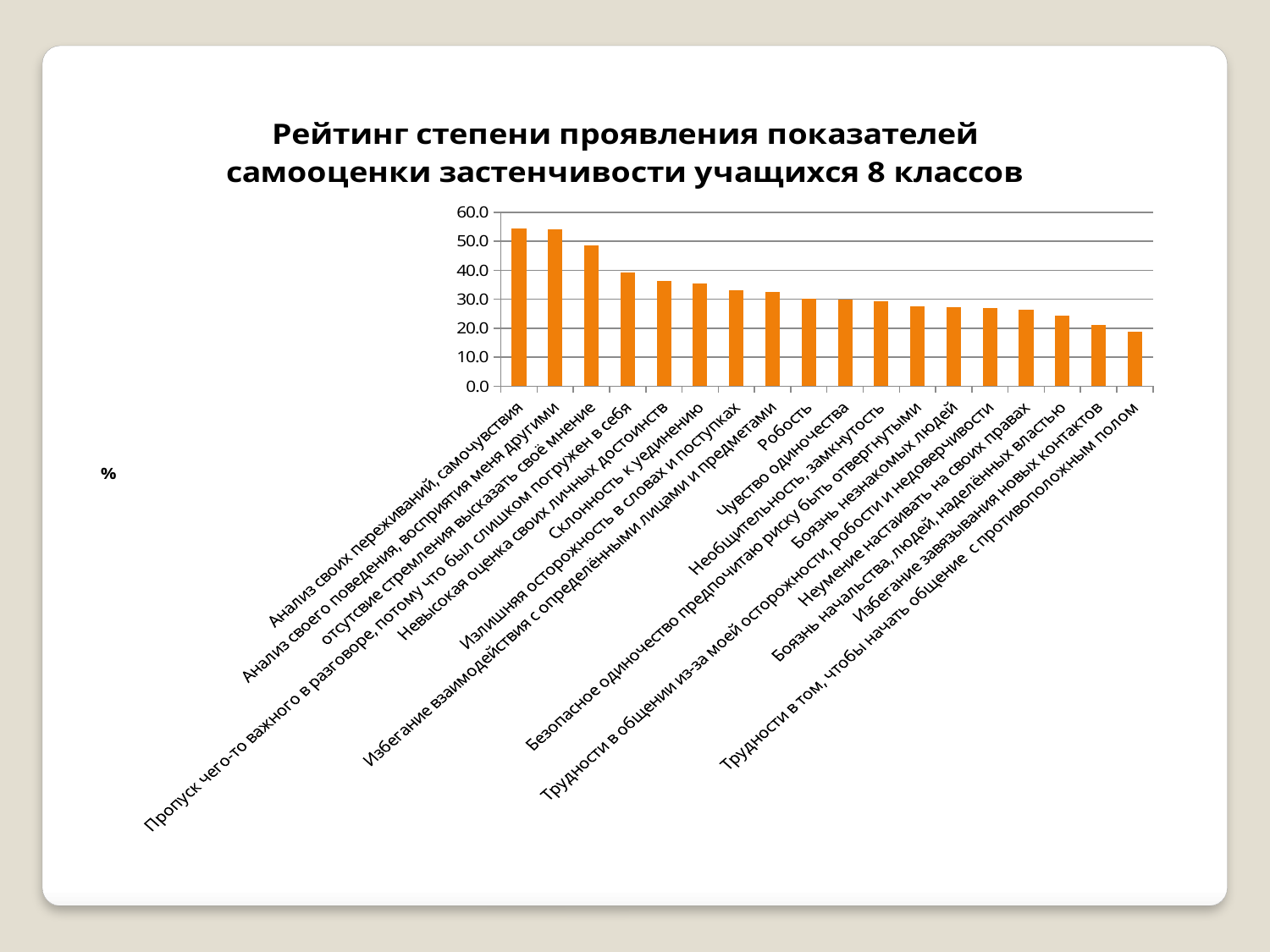
Which category has the lowest value in the chart? Трудности в том, чтобы начать общение с противоположным полом Is the value for "Боязнь незнакомых людей" greater or less than 30? less What colour are the bars in the chart? orange Is the value for "Склонность к уединению" greater or less than 40? less How many categories (bars) does the chart show? 18 Is the value for "Склонность к уединению" greater or less than 30? greater What is the title of the chart? Рейтинг степени проявления показателей самооценки застенчивости учащихся 8 классов What kind of chart is shown on the slide? bar chart Which is larger: the value for "Невысокая оценка своих личных достоинств" or the value for "Боязнь начальства, людей, наделённых властью"? Невысокая оценка своих личных достоинств Do the bar values rise or fall from left to right along the x axis? fall